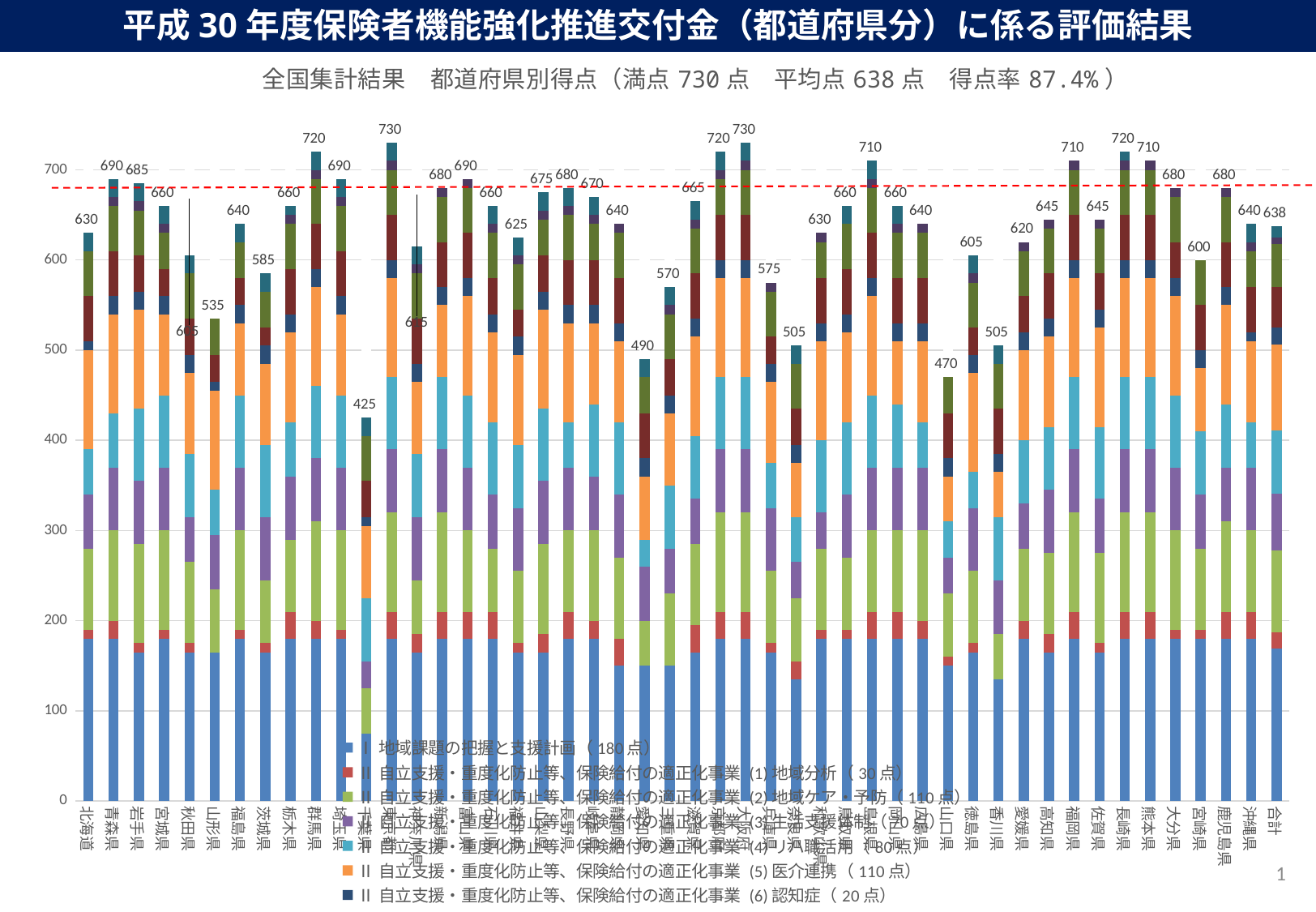
What is the difference between the scores of 青森県 and 岩手県? 5 What is the difference between the scores of 長崎県 and 沖縄県? 80 What is the total score shown for 群馬県? 720 What kind of chart is shown on the slide? Stacked bar chart What is the value shown for the 合計 bar at the far right? 638 Is the score for 山口県 greater or less than 500? less According to the chart title, what is the average score (平均点)? 638点 What is the total score shown for 宮崎県? 600 What is the total score shown for 山形県? 535 What is the total score shown for 北海道? 630 Which has the higher score, 福岡県 or 佐賀県? 福岡県 How many series does the legend list? 7